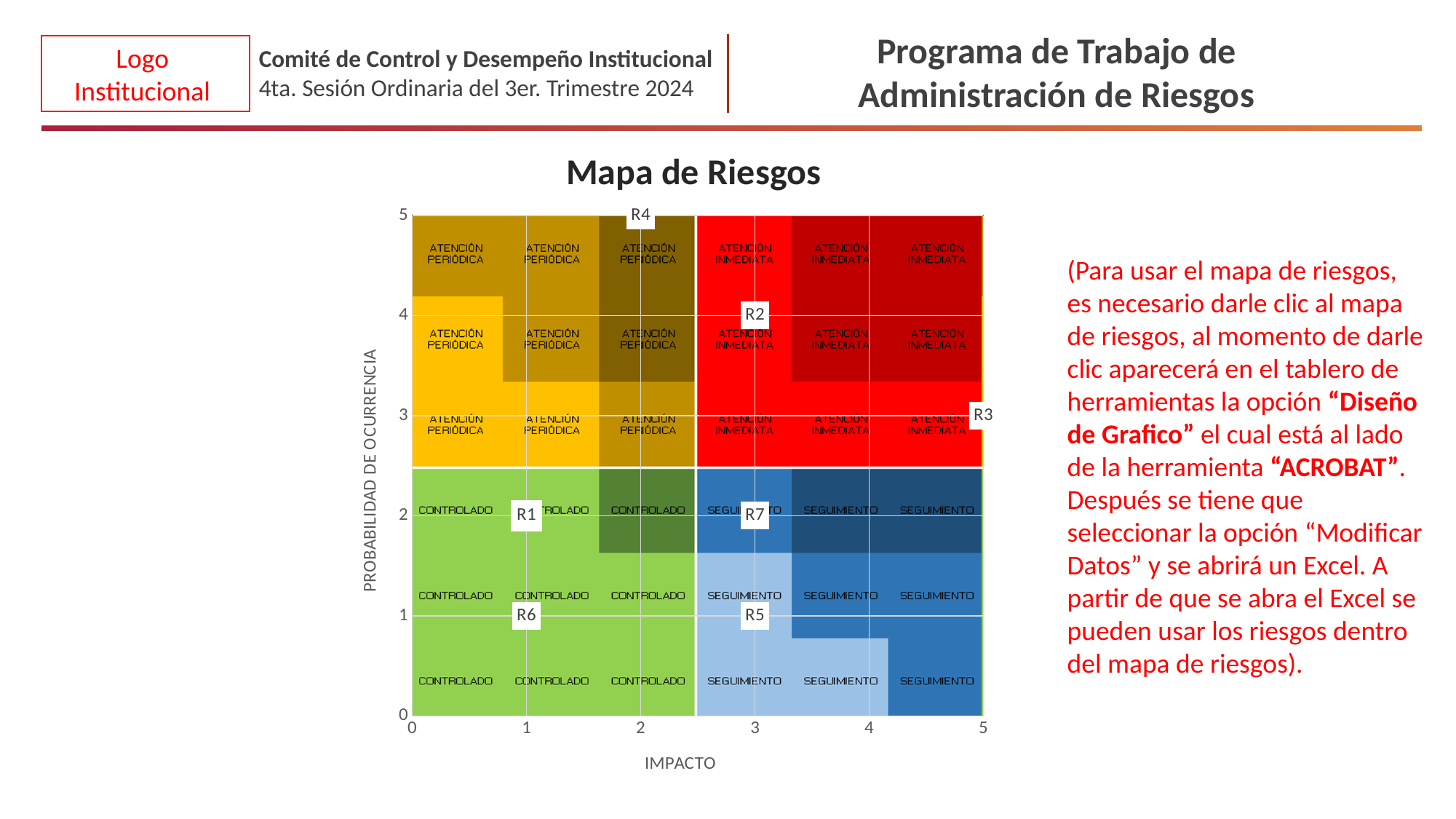
What is the impact (x-axis value) for R3? 5 In which zone of the map is R3 located? ATENCIÓN INMEDIATA What is the probability of occurrence (y-axis value) for R4? 5 Which risk has the highest impact? R3 How many risk points (R labels) are plotted on the chart? 7 What is the title of the chart? Mapa de Riesgos Is the probability of occurrence for R2 greater or less than 3? greater What is the impact (x-axis value) for R2? 3 Which has a higher probability of occurrence, R4 or R1? R4 What is the probability of occurrence (y-axis value) for R6? 1 What kind of chart is the Mapa de Riesgos? Scatter chart Which risk has the highest probability of occurrence? R4